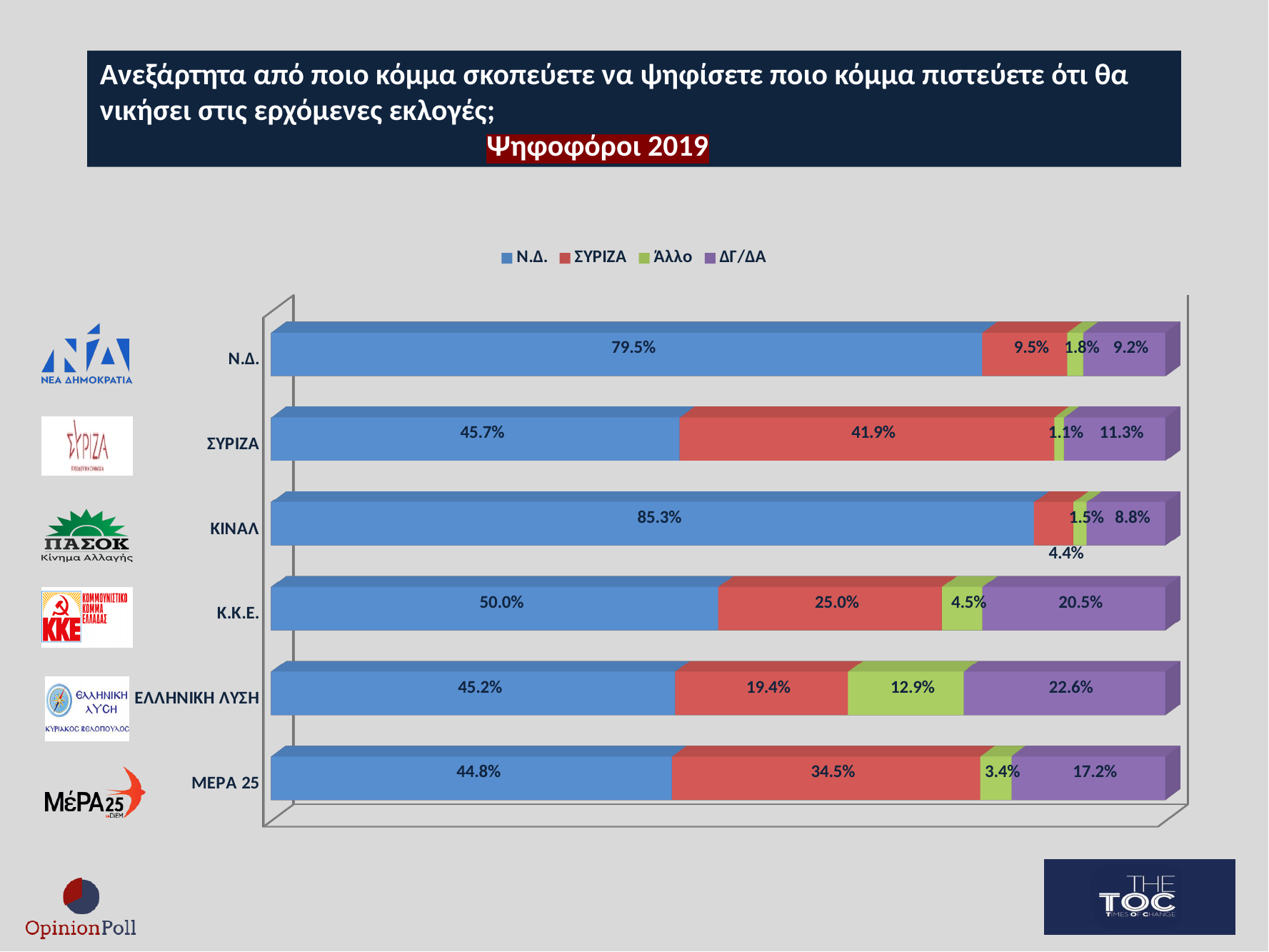
What type of chart is shown on the slide? Stacked bar chart Which voter group has the lowest Ν.Δ. value? ΜΕΡΑ 25 Which series is shown in green in the legend? Άλλο What is the difference between the Ν.Δ. value and the ΣΥΡΙΖΑ value for Κ.Κ.Ε. voters? 25.0% How many voter groups (categories) are shown on the chart? 6 How many series does the legend list? 4 Which voter group has the highest Ν.Δ. value? ΚΙΝΑΛ Which is larger for ΜΕΡΑ 25 voters: the ΣΥΡΙΖΑ value or the ΔΓ/ΔΑ value? ΣΥΡΙΖΑ What share of ΚΙΝΑΛ voters believe Ν.Δ. will win the next elections? 85.3% What share of ΣΥΡΙΖΑ voters believe ΣΥΡΙΖΑ will win the next elections? 41.9% What is the Άλλο value for ΜΕΡΑ 25 voters? 3.4% What is the ΔΓ/ΔΑ value for ΕΛΛΗΝΙΚΗ ΛΥΣΗ voters? 22.6%